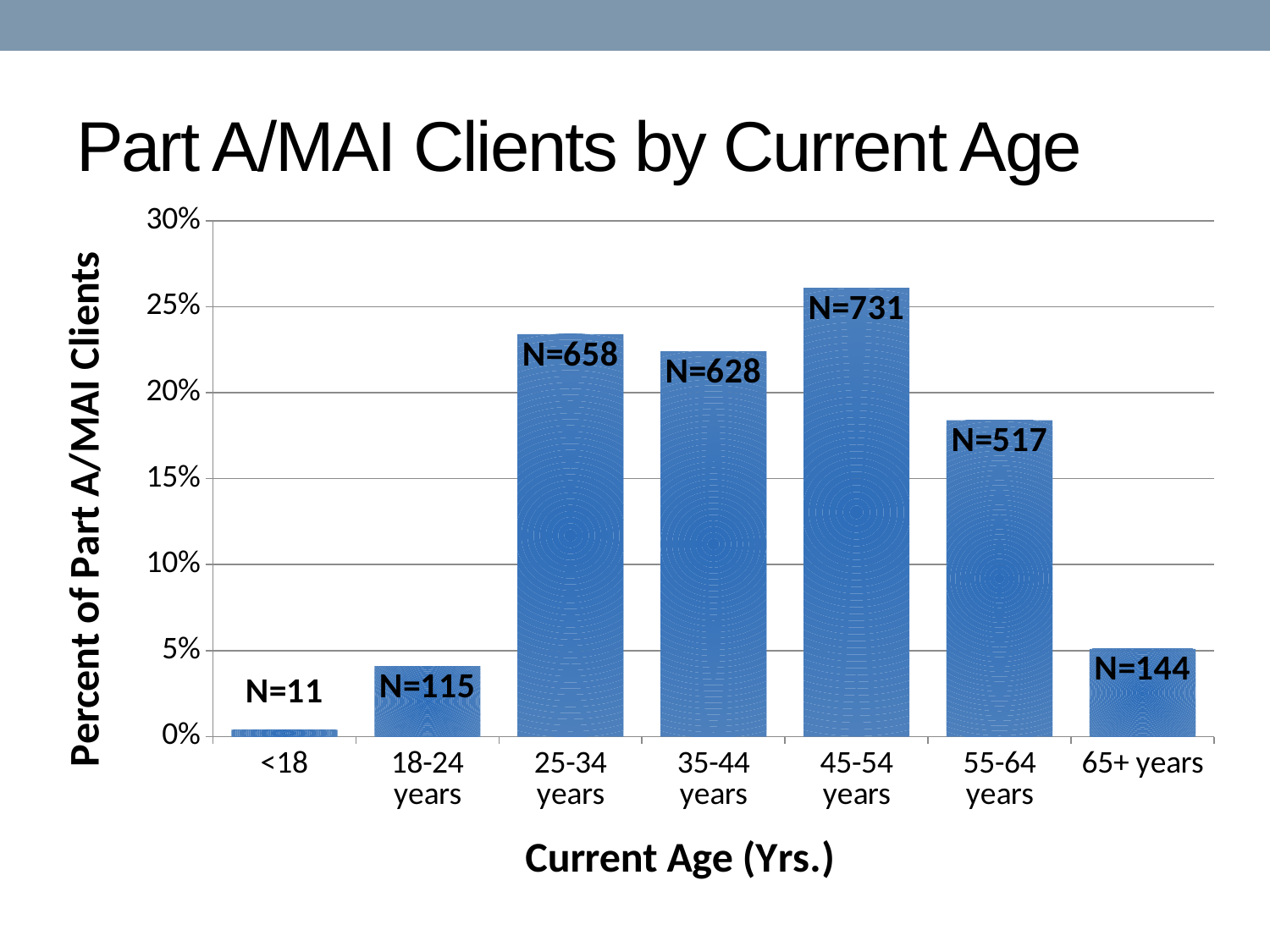
Which age group has the tallest bar? 45-54 years What is the label of the x axis? Current Age (Yrs.) What type of chart is shown on the slide? Bar chart What is the N value shown for the 45-54 years age group? N=731 Is the percentage for the 45-54 years group greater or less than 25%? greater What is the N value shown for the 65+ years age group? N=144 Is the percentage for the 55-64 years group greater or less than 20%? less Which has a larger N value, the 55-64 years group or the 18-24 years group? 55-64 years What is the difference between the N values for the 25-34 years and 35-44 years groups? 30 What is the N value shown for the <18 age group? N=11 How many age groups are shown on the x axis? 7 Which age group has the shortest bar? <18